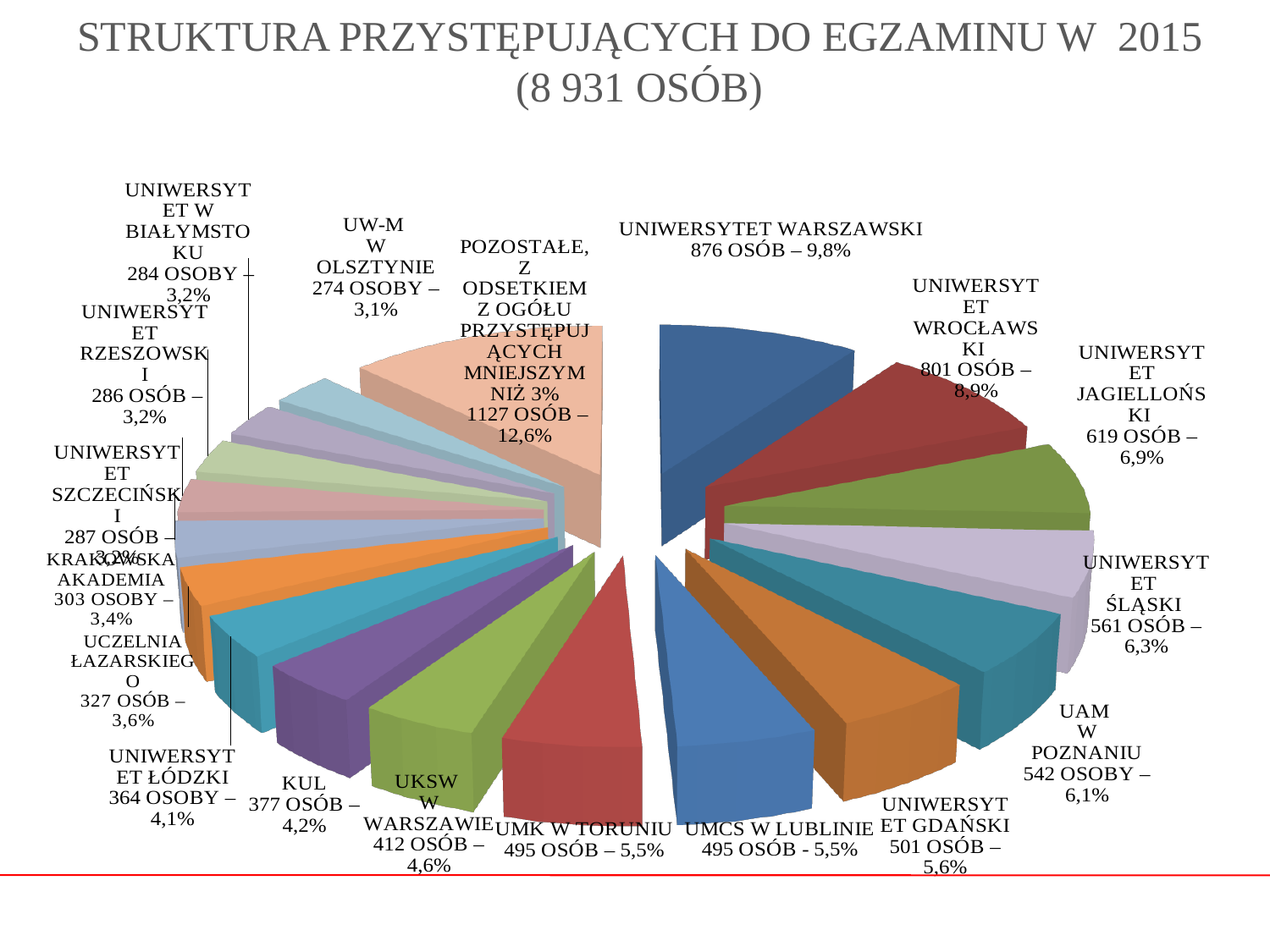
How many slices does the pie chart have? 18 What is the difference in number of people between UNIWERSYTET WARSZAWSKI and UNIWERSYTET WROCŁAWSKI? 75 What percentage share is shown for KUL? 4,2% What kind of chart is shown on the slide? Pie chart Which slice of the pie is the largest? POZOSTAŁE (1127 OSÓB – 12,6%) How many people are shown for UKSW W WARSZAWIE? 412 OSÓB Which has more people, UNIWERSYTET GDAŃSKI or UMCS W LUBLINIE? UNIWERSYTET GDAŃSKI What percentage share is shown for UNIWERSYTET ŚLĄSKI? 6,3% How many people (osób) does the slice for UNIWERSYTET WARSZAWSKI represent? 876 OSÓB Which named university has the smallest slice? UW-M W OLSZTYNIE (274 OSOBY – 3,1%) What is the difference in number of people between UNIWERSYTET JAGIELLOŃSKI and UNIWERSYTET ŚLĄSKI? 58 What total number of people is given in the slide title? 8 931 OSÓB